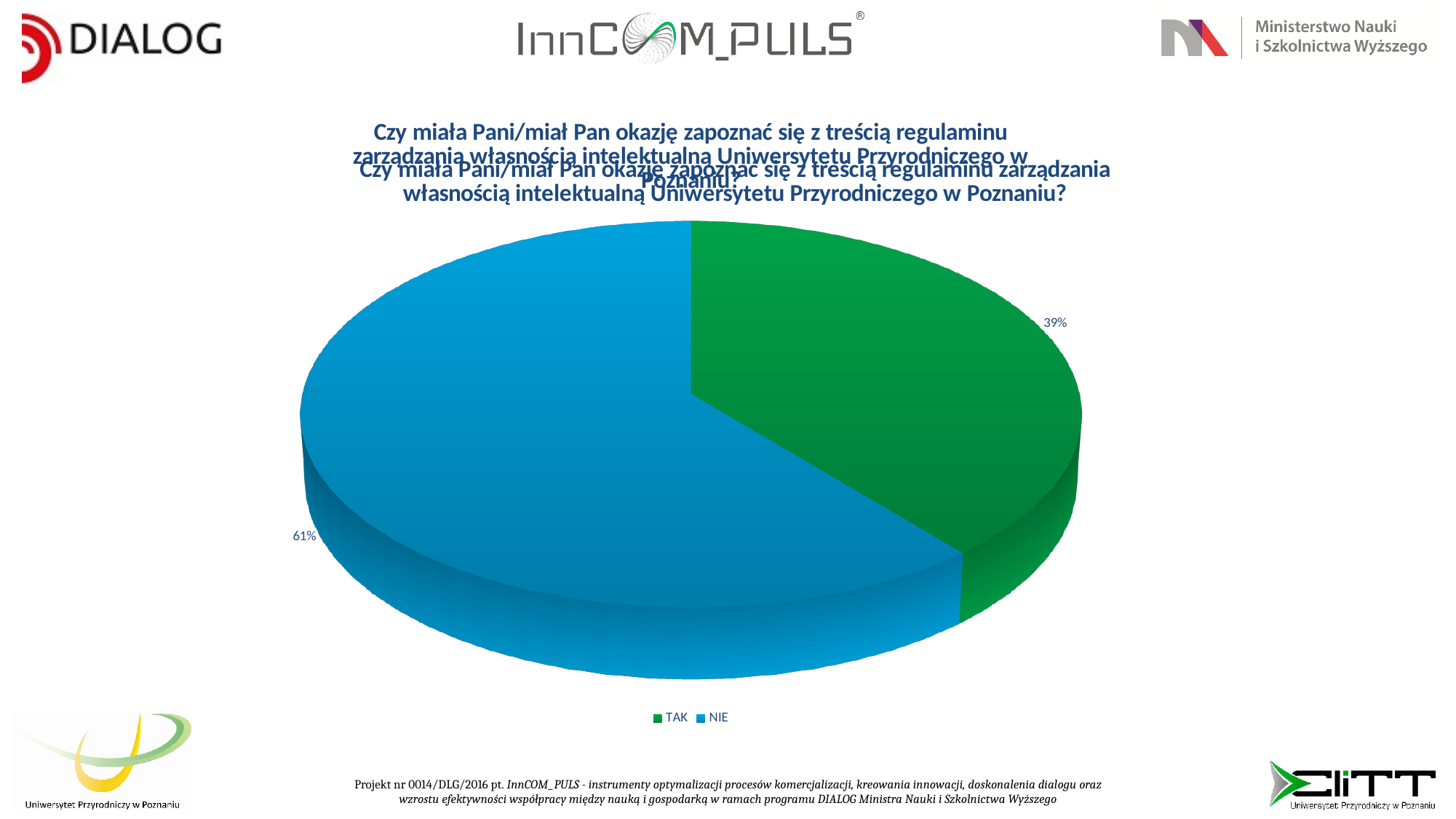
What percentage of the pie is the TAK slice? 39% What kind of chart is shown on the slide? pie chart What colour is the NIE slice in the pie chart? blue What percentage of the pie is the NIE slice? 61% How many slices does the pie chart have? 2 Which slice is the smallest in the pie chart? TAK Is the share of the TAK slice greater or less than 50%? less What colour is the TAK slice in the pie chart? green Which slice is the largest in the pie chart? NIE Which is larger, the TAK slice or the NIE slice? NIE What is the difference in percentage points between the NIE slice and the TAK slice? 22 How many entries does the legend list? 2